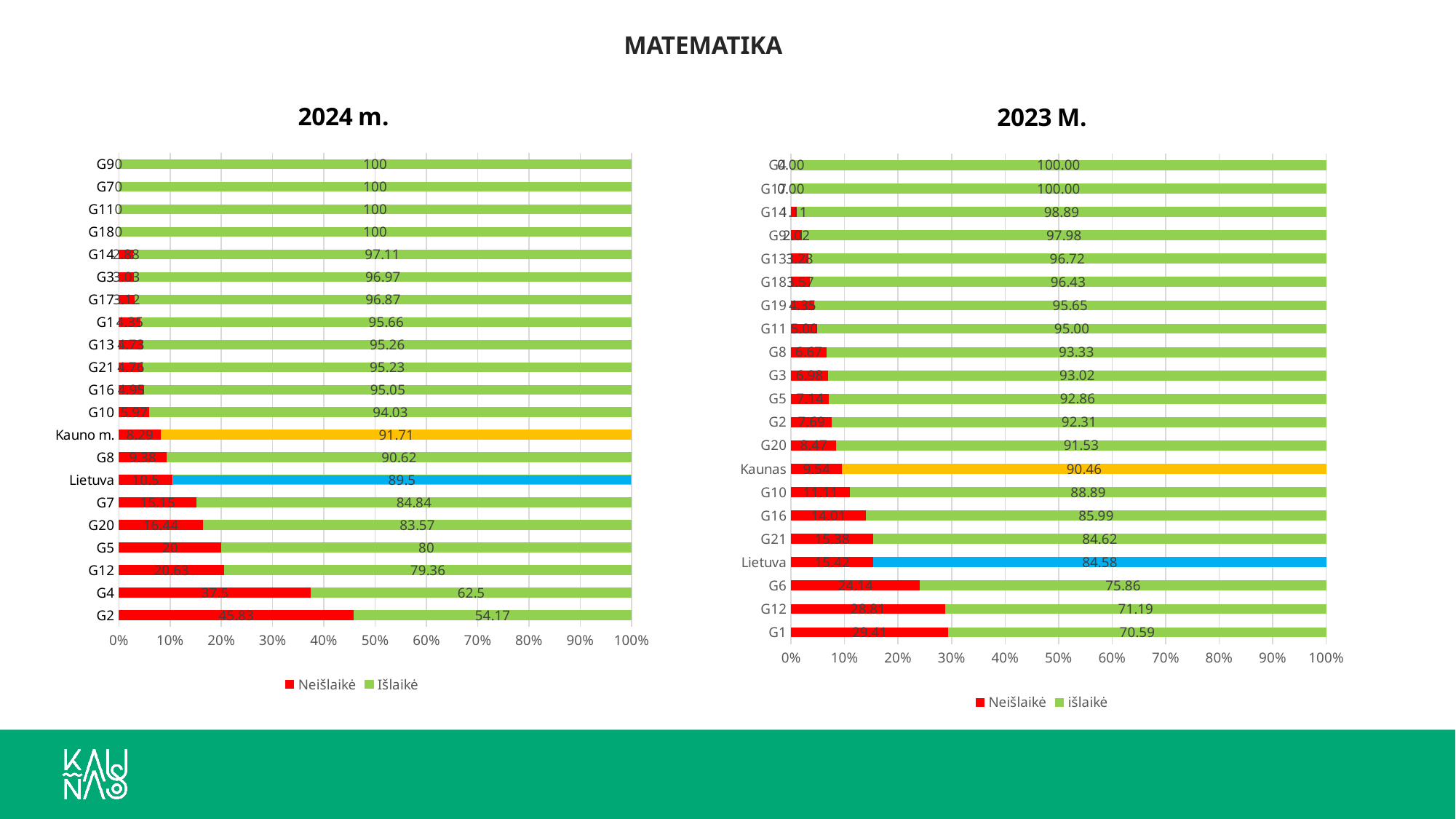
In the 2023 M. chart, which has the larger Išlaikė value, Kaunas or Lietuva? Kaunas In the 2024 m. chart, what is the Išlaikė value for G2? 54.17 In the 2023 M. chart, which category has the lowest Išlaikė value? G1 In the 2024 m. chart, which category has the highest Neišlaikė value? G2 In the 2024 m. chart, what is the Išlaikė value for Kauno m.? 91.71 How many series does the legend of the 2024 m. chart list? 2 What kind of chart is the 2023 M. chart? Stacked bar chart In the 2024 m. chart, what is the total of the stacked bar for G2? 100 In the 2024 m. chart, what is the Neišlaikė value for G4? 37.5 In the 2023 M. chart, what is the Išlaikė value for Lietuva? 84.58 In the 2024 m. chart, what is the difference between the Išlaikė values for G4 and G2? 8.33 In the 2023 M. chart, what is the Neišlaikė value for G1? 29.41